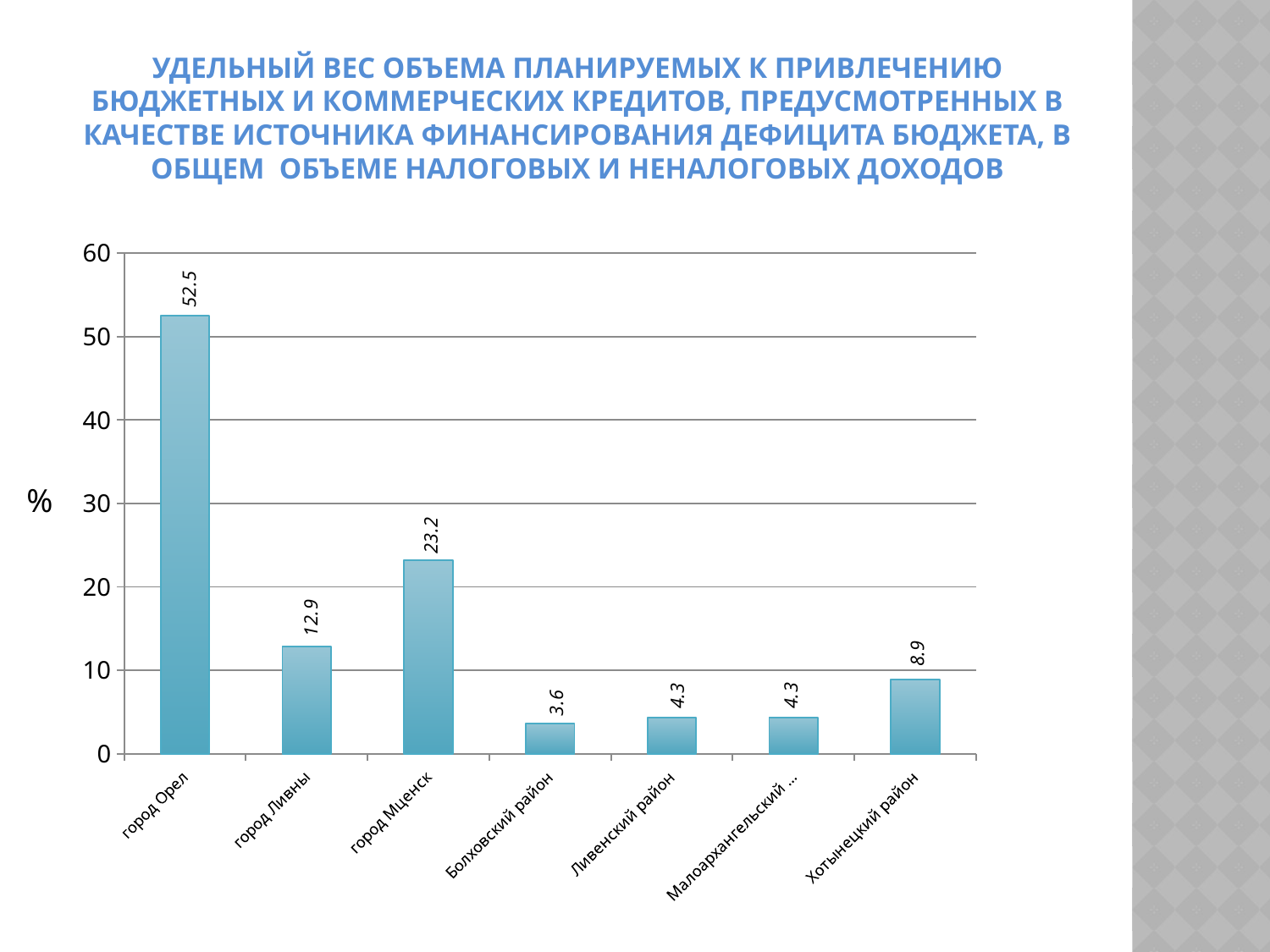
What is the difference between the values for город Орел and город Мценск? 29.3 What is the value for Болховский район? 3.6 How many categories are shown on the x axis? 7 Which category has the lowest value? Болховский район What unit label is shown on the vertical axis? % What kind of chart is shown on the slide? bar chart What is the value for город Орел? 52.5 What is the value for Хотынецкий район? 8.9 What is the value for город Мценск? 23.2 Which is larger, the value for город Ливны or the value for город Мценск? город Мценск What is the difference between the values for город Ливны and Хотынецкий район? 4 Which category has the highest value? город Орел